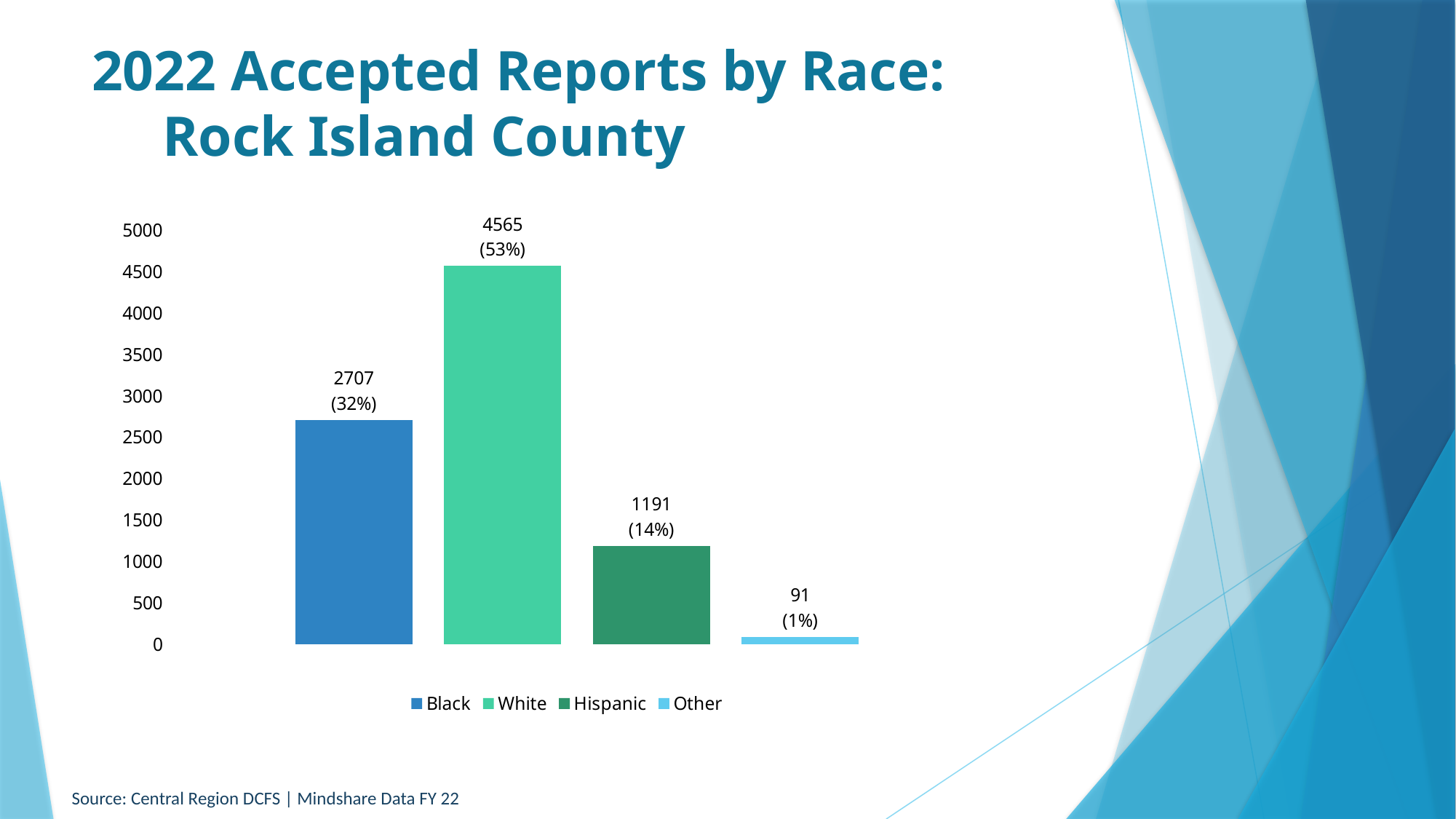
Which race category has the highest number of accepted reports? White What is the number of accepted reports for White? 4565 What is the difference between the number of accepted reports for White and Black? 1858 How many race categories are shown in the chart? 4 Which race category has the lowest number of accepted reports? Other What kind of chart is shown on the slide? Bar chart What percentage of accepted reports is shown for Other? 1% What is the number of accepted reports for Hispanic? 1191 What is the source cited at the bottom of the slide? Central Region DCFS | Mindshare Data FY 22 Is the value for Hispanic greater or less than 1500? less What is the number of accepted reports for Black? 2707 Which has more accepted reports, Black or Hispanic? Black